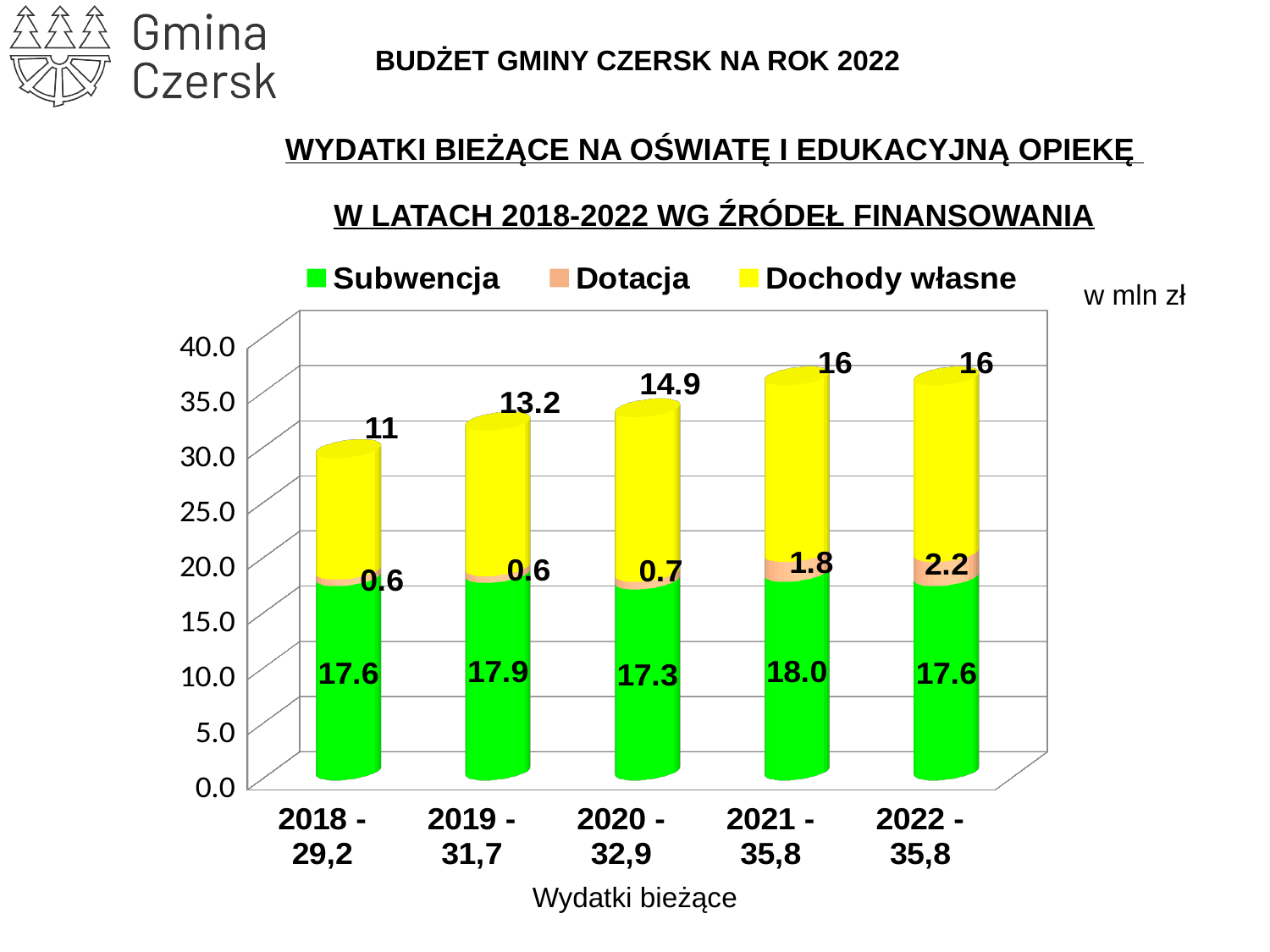
Which year has the highest Dotacja value? 2022 What is the Dotacja value for 2022? 2.2 What is the difference between the Dochody własne values for 2020 and 2018? 3.9 How many series does the legend list? 3 What kind of chart is shown on the slide? stacked bar chart What is the Subwencja value for 2021? 18.0 What is the total of the stacked bar for 2020? 32,9 Which year has the lowest Dochody własne value? 2018 Which colour represents Dochody własne in the legend? yellow What is the Dochody własne value for 2019? 13.2 Which is larger, the Subwencja value for 2019 or for 2020? 2019 How many years are shown on the x axis? 5